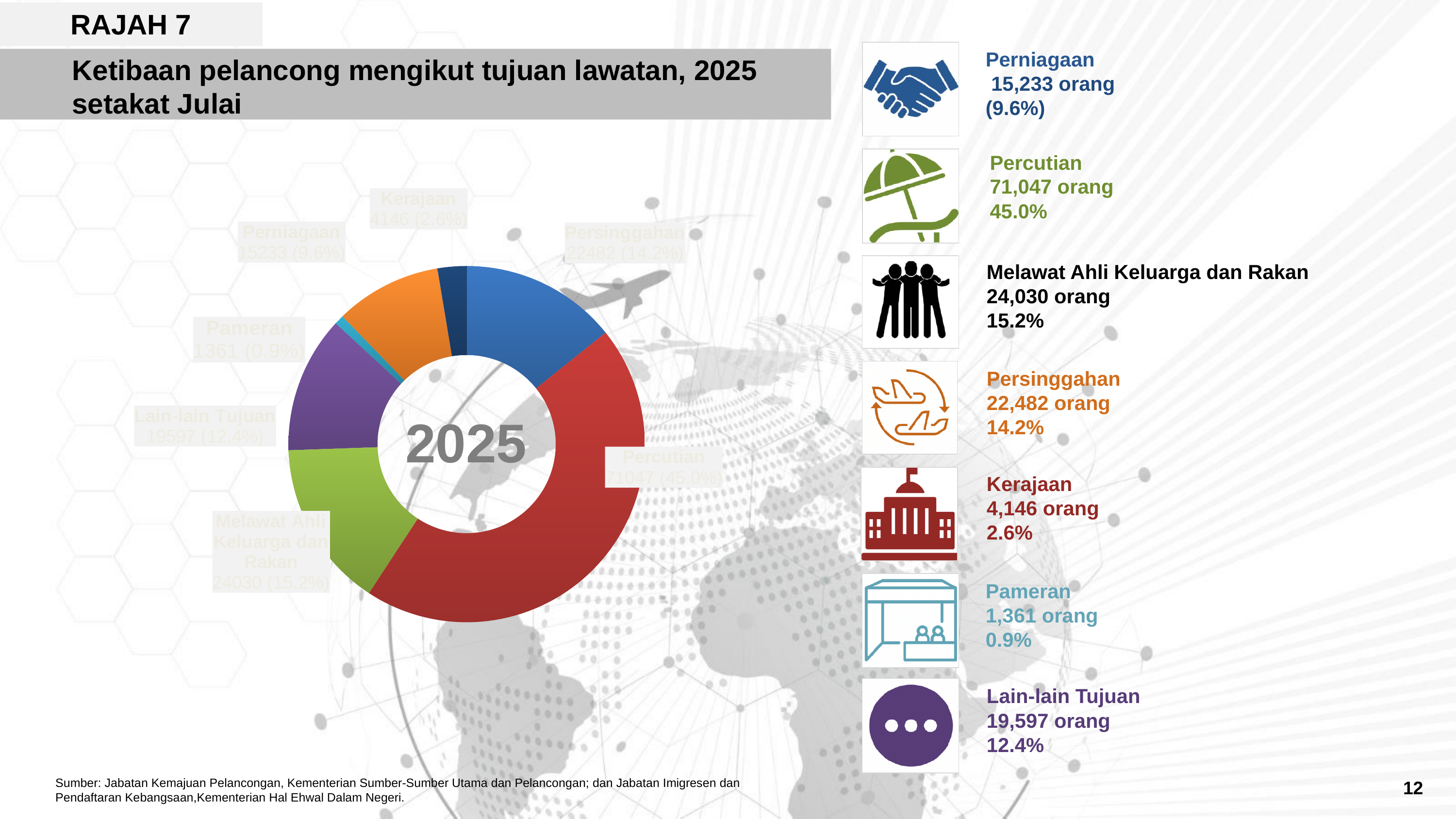
How many tourist arrivals are shown for Percutian? 71,047 orang What year is printed in the centre of the donut chart? 2025 What share of arrivals is attributed to Kerajaan? 2.6% Which purpose of visit has the highest number of arrivals? Percutian What is the title of the chart? Ketibaan pelancong mengikut tujuan lawatan, 2025 setakat Julai How many purpose-of-visit categories does the chart show? 7 What percentage share does Melawat Ahli Keluarga dan Rakan have? 15.2% What kind of chart is shown on the slide? Donut (pie) chart Which purpose of visit has the lowest number of arrivals? Pameran How many arrivals are shown for Persinggahan? 22,482 orang What is the difference in arrivals between Melawat Ahli Keluarga dan Rakan and Persinggahan? 1,548 Which has more arrivals, Perniagaan or Lain-lain Tujuan? Lain-lain Tujuan